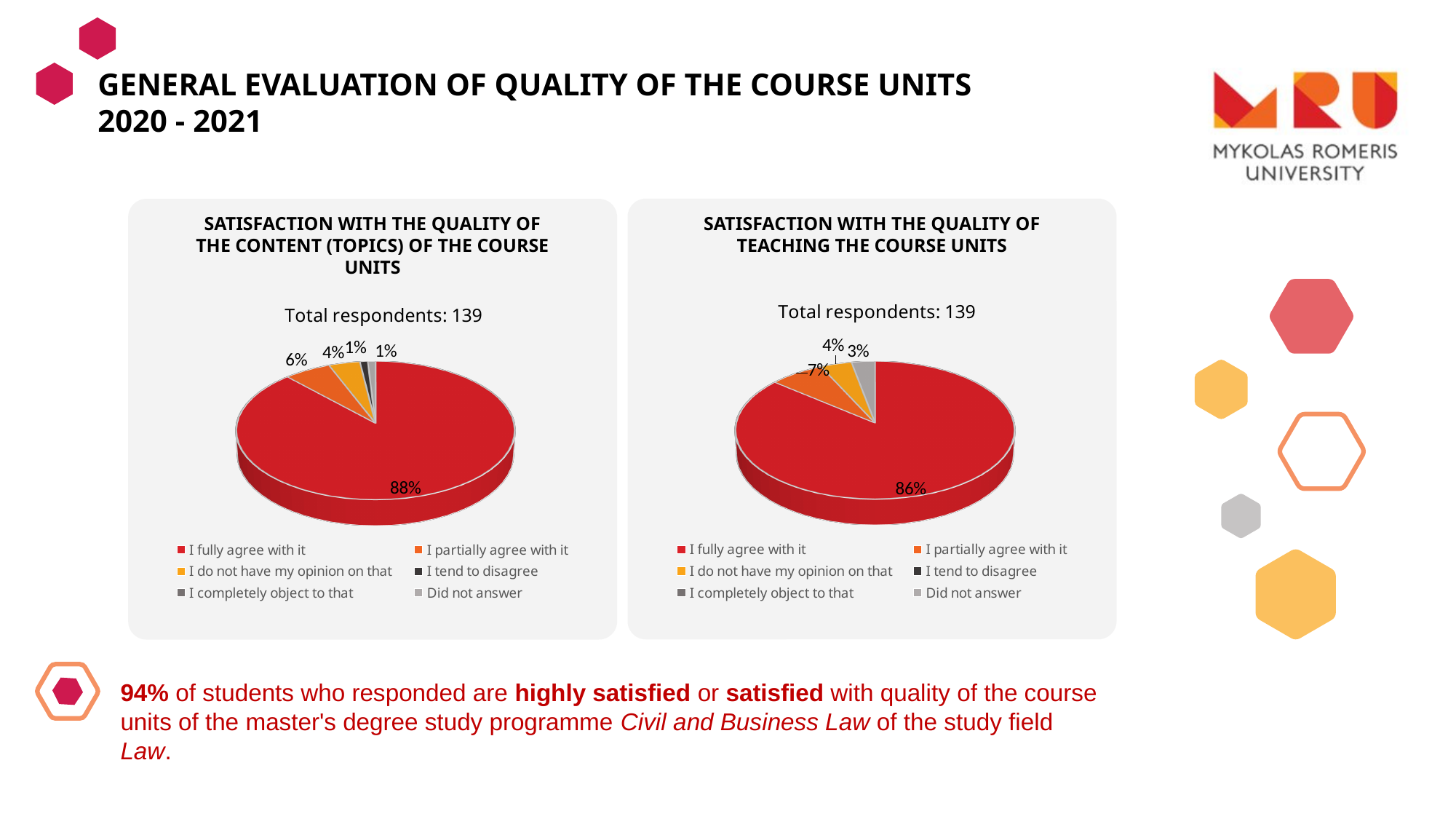
How many total respondents are reported for the 'Satisfaction with the quality of teaching the course units' chart? 139 In the 'Satisfaction with the quality of teaching the course units' chart, what share of respondents partially agree with it? 7% What type of chart is used for 'Satisfaction with the quality of teaching the course units'? Pie chart In the 'Satisfaction with the quality of the content (topics) of the course units' chart, what colour is the 'I fully agree with it' slice? Red In the 'Satisfaction with the quality of teaching the course units' chart, what share of respondents did not answer? 3% How many entries does the legend of the 'Satisfaction with the quality of the content (topics) of the course units' chart list? 6 In the 'Satisfaction with the quality of the content (topics) of the course units' chart, which response has the largest share? I fully agree with it In the 'Satisfaction with the quality of the content (topics) of the course units' chart, what share of respondents partially agree with it? 6% Which chart has the larger share for 'I fully agree with it', the content chart or the teaching chart? The content chart What is the difference between the 'I fully agree with it' shares in the content chart (88%) and the teaching chart (86%)? 2 percentage points In the 'Satisfaction with the quality of teaching the course units' chart, what share of respondents fully agree with it? 86% In the 'Satisfaction with the quality of the content (topics) of the course units' chart, what share of respondents fully agree with it? 88%